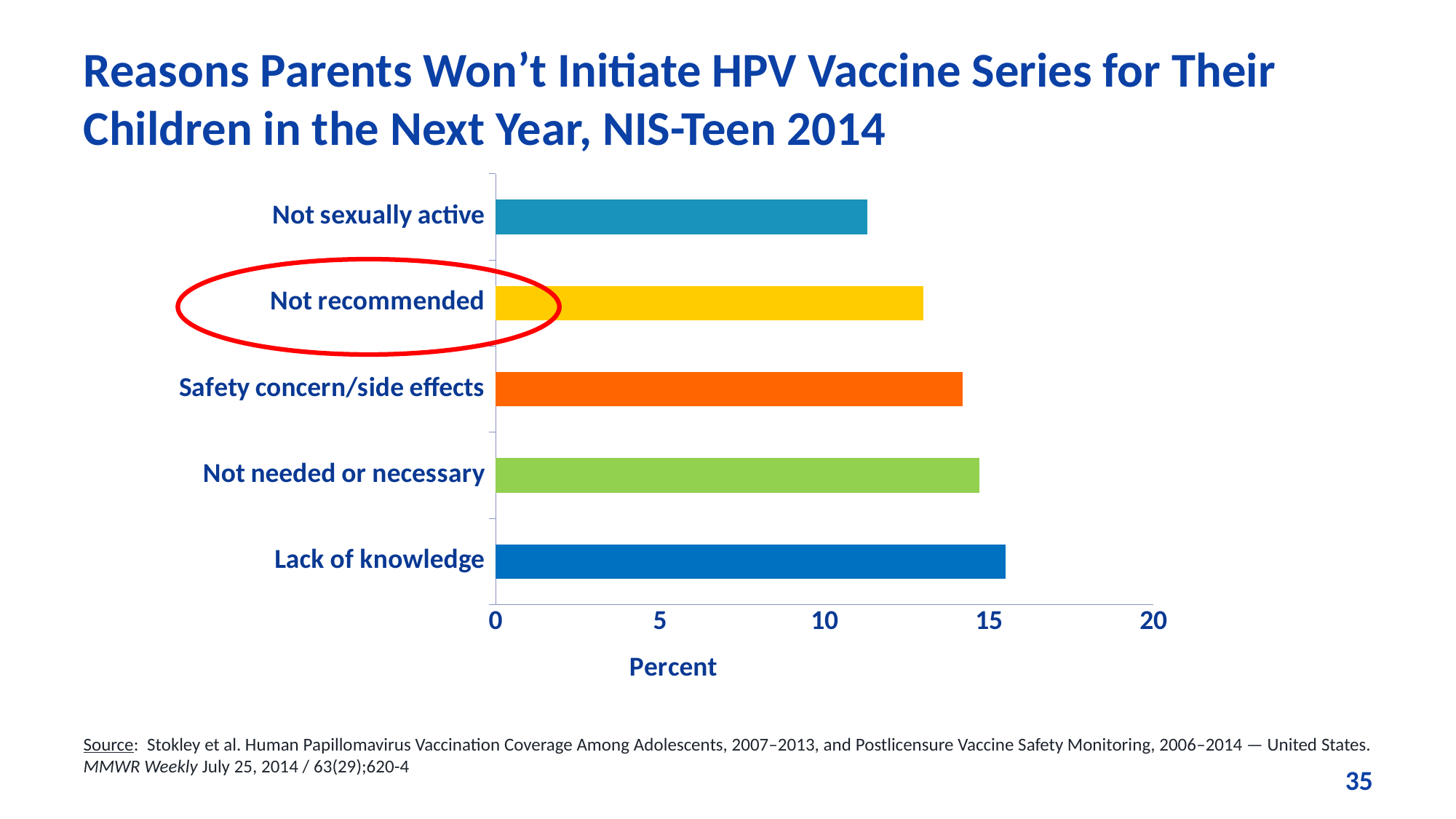
Which is larger, the value for Not needed or necessary or the value for Not recommended? Not needed or necessary How many reasons (categories) are plotted in the chart? 5 What is the label of the horizontal axis? Percent Which is larger, the value for Safety concern/side effects or the value for Not sexually active? Safety concern/side effects What kind of chart is shown on the slide? Bar chart Which reason has the lowest percentage? Not sexually active Is the value for Not recommended greater or less than 10? greater Which category label is circled in red on the chart? Not recommended Which reason has the highest percentage? Lack of knowledge Is the value for Not recommended greater or less than 15? less Is the value for Safety concern/side effects greater or less than 15? less